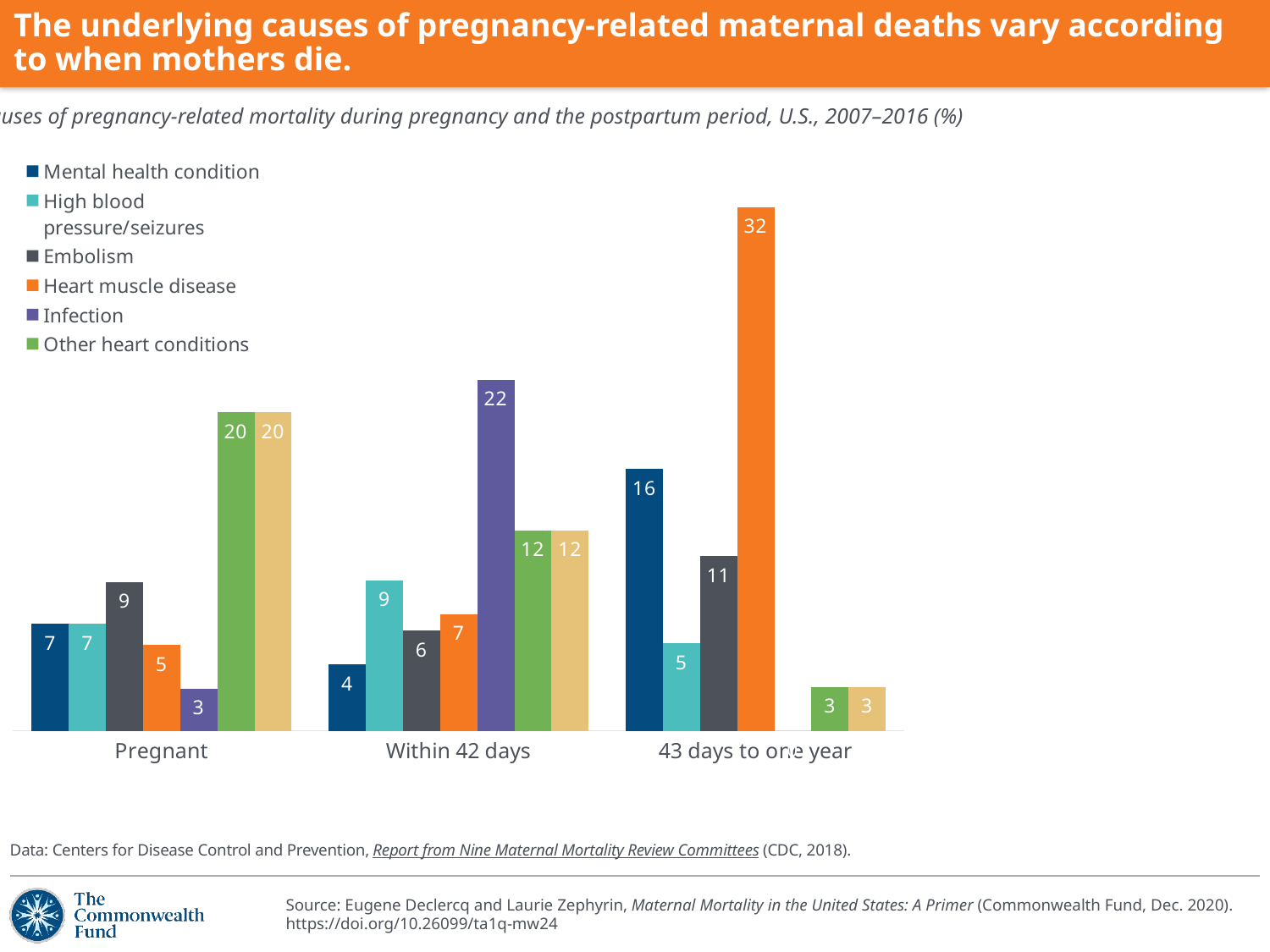
What is the difference between the Heart muscle disease values for 43 days to one year and Pregnant? 27 How many categories are shown on the x axis? 3 What is the difference between the Mental health condition values for 43 days to one year and Pregnant? 9 In which category is the value for Heart muscle disease highest? 43 days to one year Which is larger: Infection in the Within 42 days category or Embolism in the 43 days to one year category? Infection in the Within 42 days category What is the value for Heart muscle disease in the 43 days to one year category? 32 What is the value for Other heart conditions in the Pregnant category? 20 What kind of chart is shown on the slide? Bar chart How many series does the legend list? 6 What is the value for Infection in the Within 42 days category? 22 What is the value for Embolism in the Pregnant category? 9 In which category is the value for Mental health condition lowest? Within 42 days